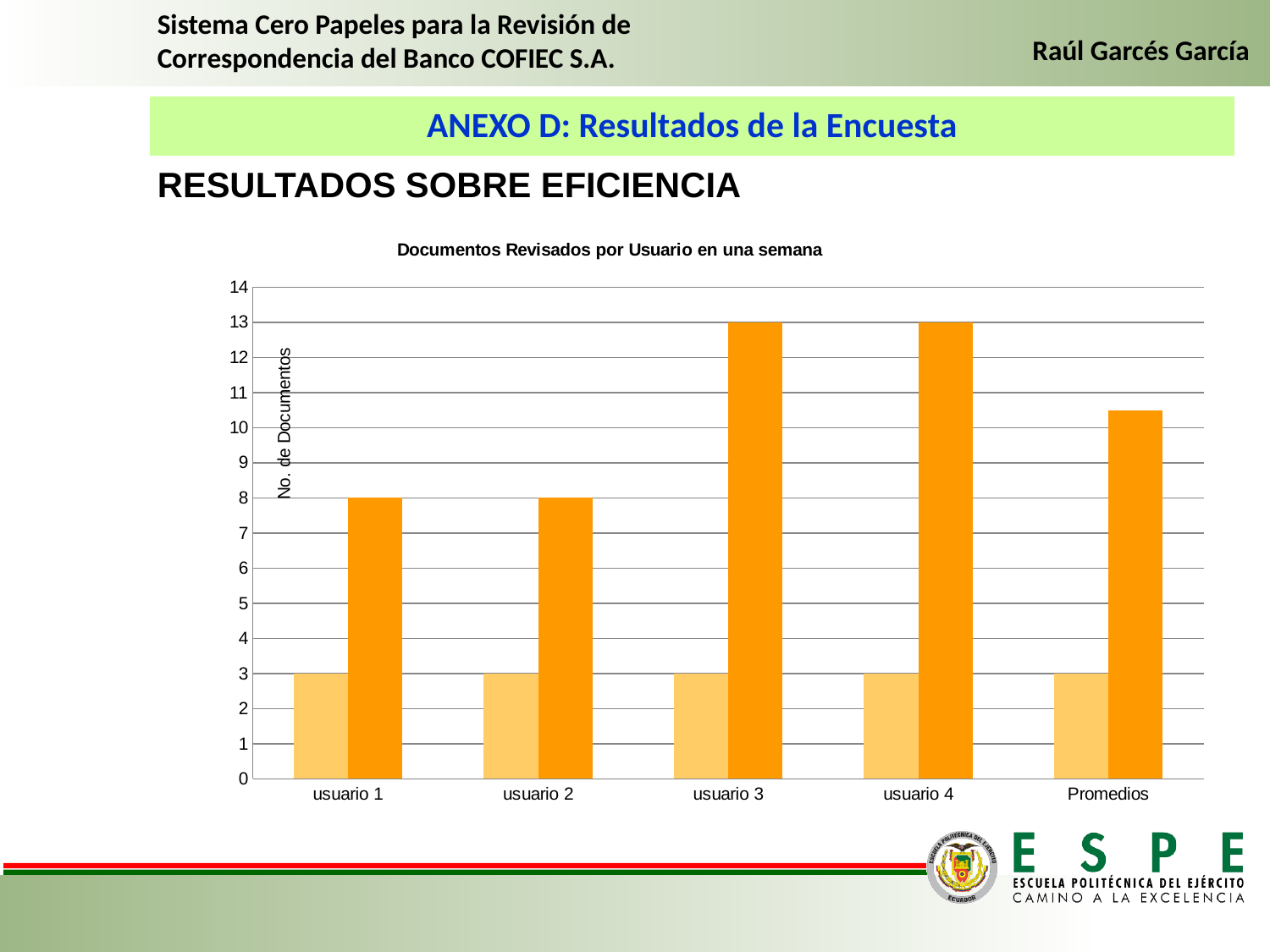
What is the difference between the dark orange bar and the light orange bar for usuario 4? 10 What kind of chart is shown under the title 'Documentos Revisados por Usuario en una semana'? Bar chart What is the label on the y axis of the chart? No. de Documentos Is the value of the dark orange bar for Promedios greater or less than 10? greater What is the difference between the dark orange bars for usuario 3 and usuario 1? 5 What is the value of the dark orange bar for usuario 3? 13 What is the value of the dark orange bar for usuario 1? 8 Which has the larger dark orange bar, usuario 3 or usuario 1? usuario 3 Which has the larger dark orange bar, usuario 2 or usuario 4? usuario 4 Is the value of the dark orange bar for Promedios greater or less than 11? less How many categories are shown on the x axis of the chart? 5 What is the value of the light orange bar for usuario 2? 3